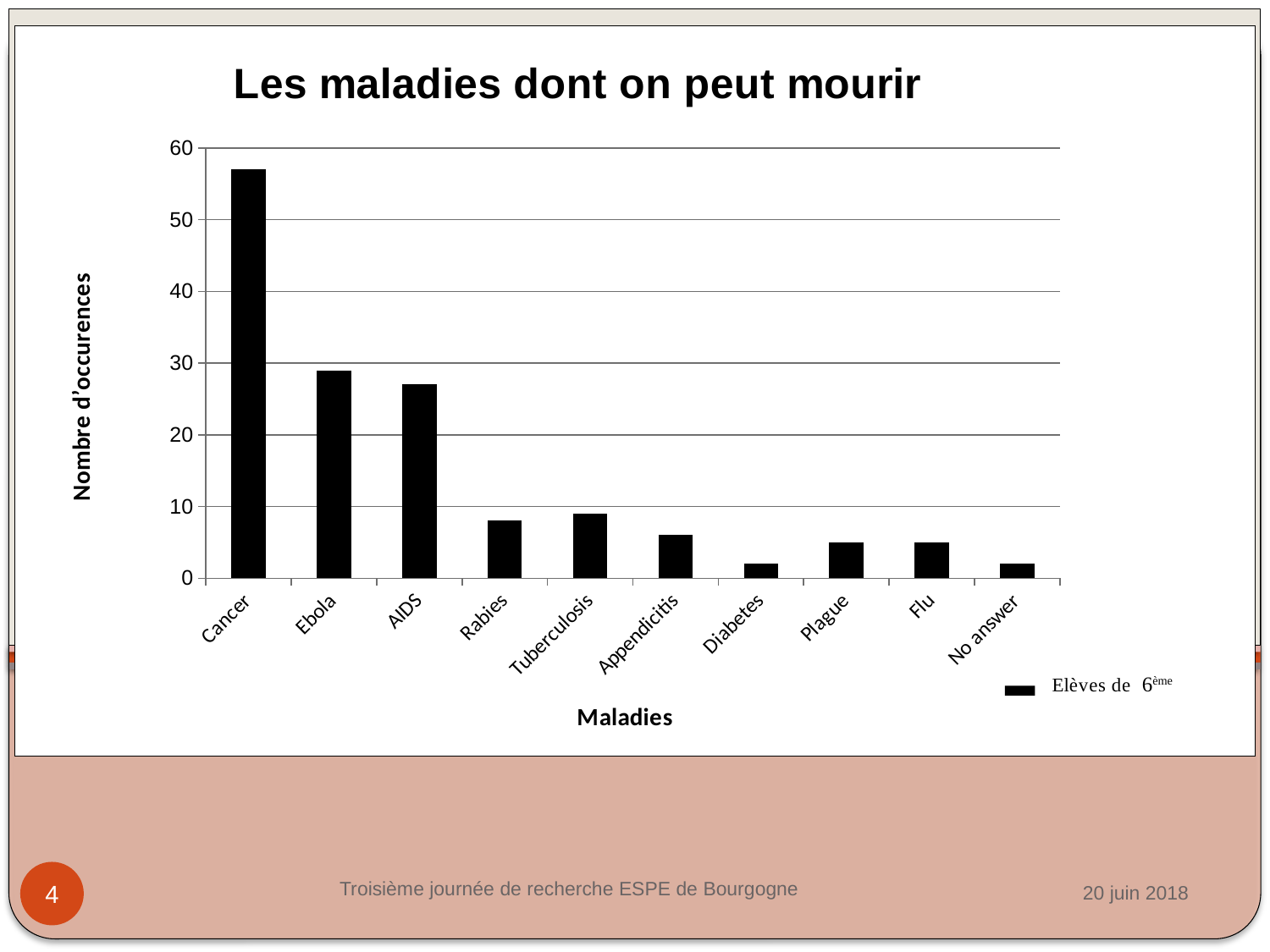
What kind of chart is shown on the slide? bar chart Which is larger, the value for Cancer or the value for Ebola? Cancer What is the title of the chart? Les maladies dont on peut mourir Is the value for Cancer greater or less than 50? greater What is the label of the y axis? Nombre d'occurences How many series does the legend list? 1 Is the value for Rabies greater or less than 10? less Which is larger, the value for Rabies or the value for Diabetes? Rabies Which disease has the highest number of occurrences? Cancer How many disease categories are shown on the x axis? 10 Is the value for AIDS greater or less than 20? greater